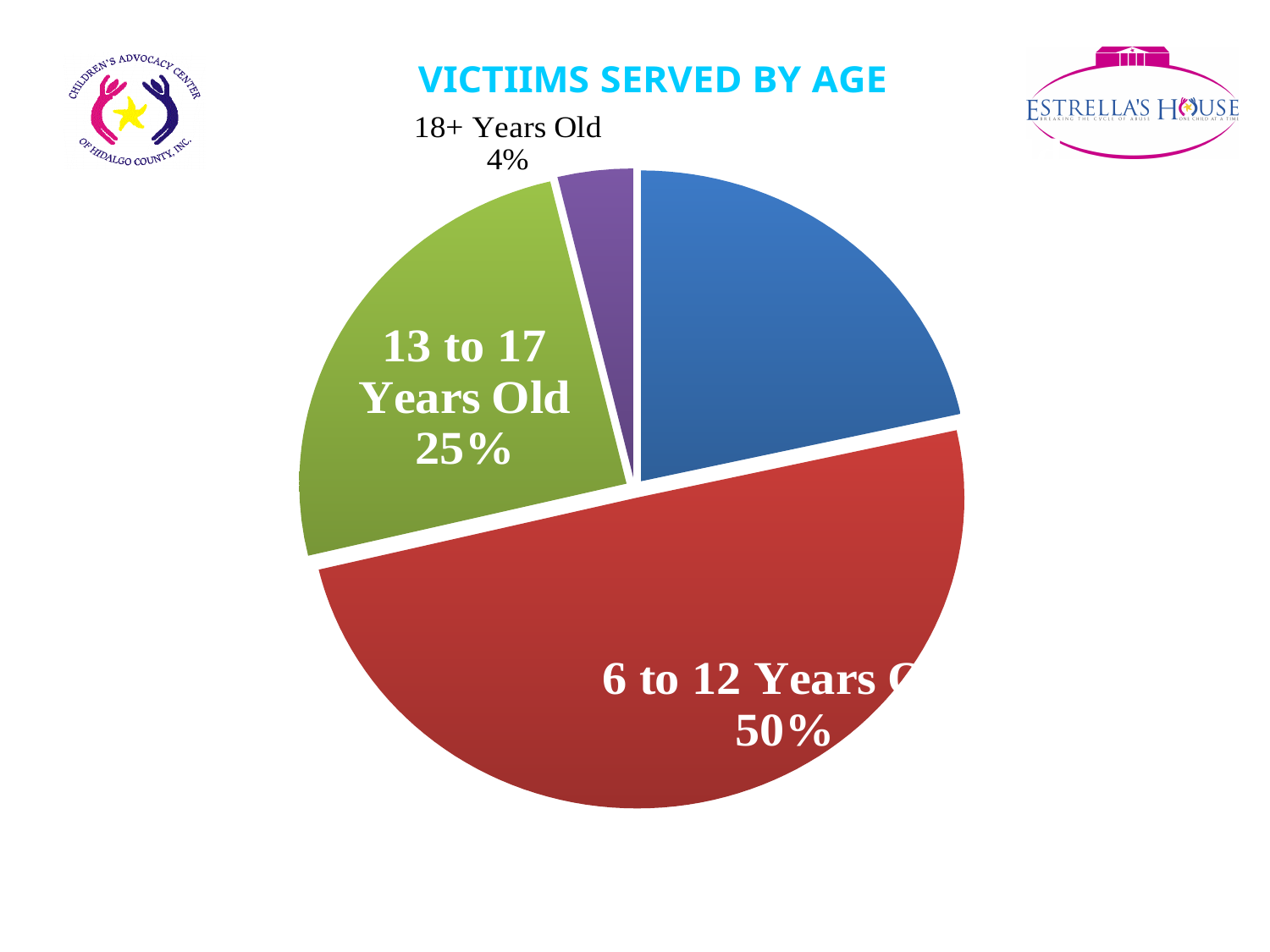
What is the difference in percentage points between the 6 to 12 Years Old and 13 to 17 Years Old slices? 25 percentage points Which age group has the largest share of victims served? 6 to 12 Years Old How many slices does the pie chart have? 4 What percentage of victims served were 18+ years old? 4% What is the title of the chart? VICTIIMS SERVED BY AGE Which age group has the smallest share of victims served? 18+ Years Old What colour is the slice for 13 to 17 Years Old? Green What percentage of victims served were 6 to 12 years old? 50% Which is larger, the share for 13 to 17 Years Old or the share for 18+ Years Old? 13 to 17 Years Old What is the difference in percentage points between the 13 to 17 Years Old and 18+ Years Old slices? 21 percentage points What kind of chart is shown on the slide? Pie chart What percentage of victims served were 13 to 17 years old? 25%